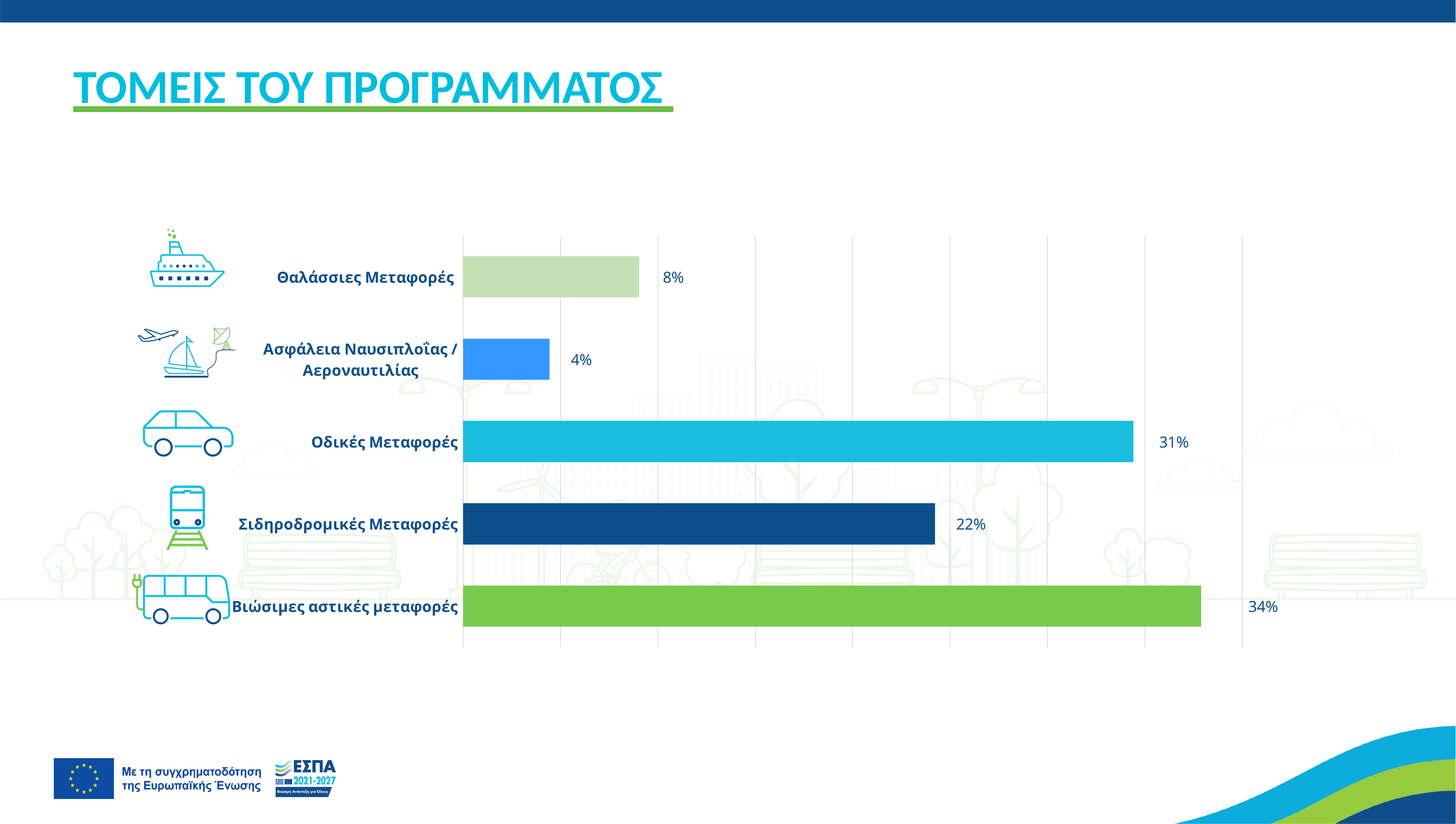
Which is larger, the value for Θαλάσσιες Μεταφορές or the value for Ασφάλεια Ναυσιπλοΐας / Αεροναυτιλίας? Θαλάσσιες Μεταφορές What is the value for Ασφάλεια Ναυσιπλοΐας / Αεροναυτιλίας? 4% What is the title of the slide containing the chart? ΤΟΜΕΙΣ ΤΟΥ ΠΡΟΓΡΑΜΜΑΤΟΣ What is the difference between the values for Οδικές Μεταφορές and Σιδηροδρομικές Μεταφορές? 9% What is the value for Θαλάσσιες Μεταφορές? 8% Which category has the highest value? Βιώσιμες αστικές μεταφορές Which category has the lowest value? Ασφάλεια Ναυσιπλοΐας / Αεροναυτιλίας What is the value for Οδικές Μεταφορές? 31% How many categories are shown in the chart? 5 What is the value for Βιώσιμες αστικές μεταφορές? 34% What is the value for Σιδηροδρομικές Μεταφορές? 22% What kind of chart is shown on the slide? Bar chart